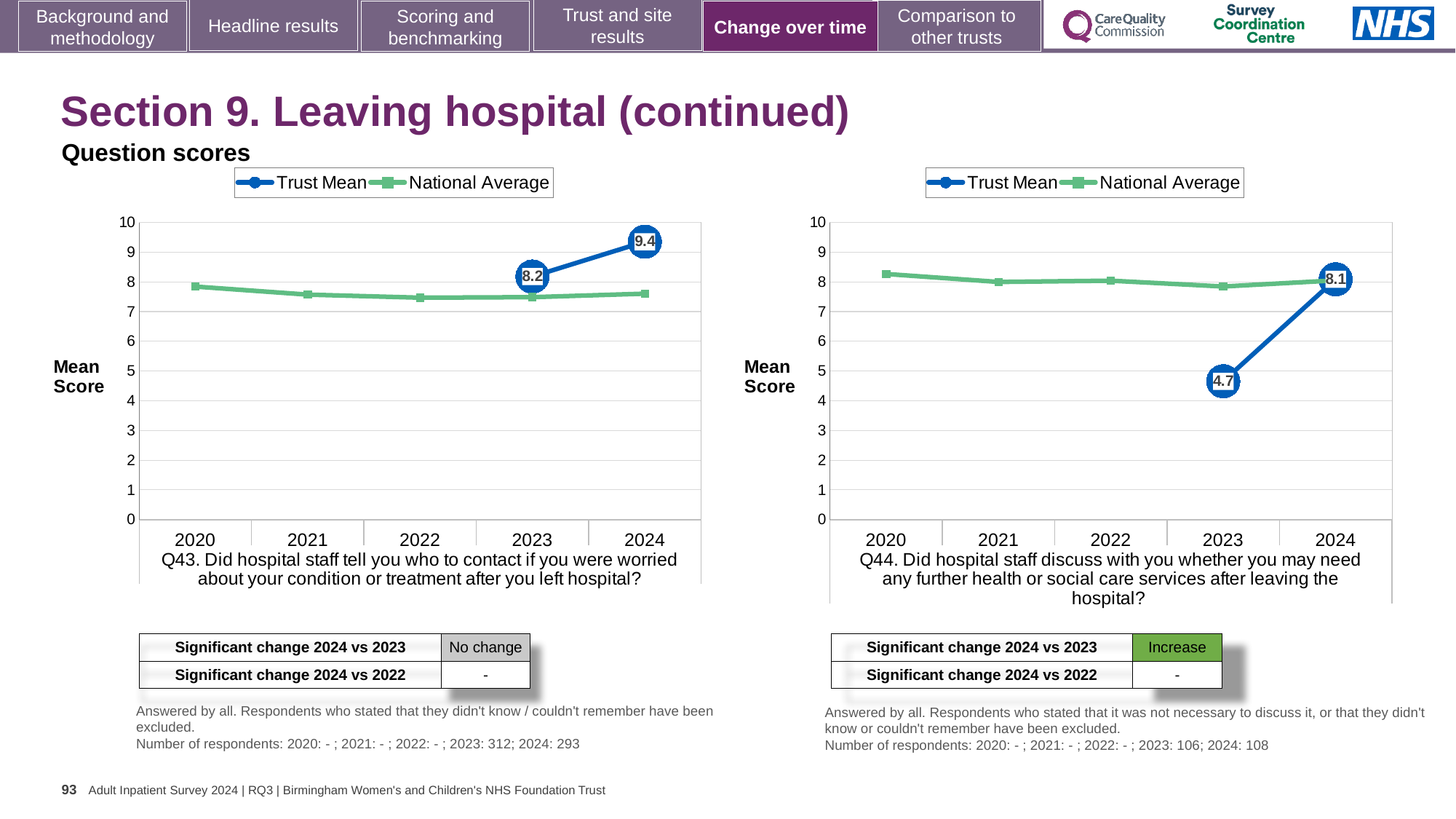
In the Q44 chart on the right, is the National Average value for 2020 greater or less than 8? greater In the Q43 chart on the left, what is the Trust Mean score for 2024? 9.4 What type of chart is used for the Q43 chart on the left? Line chart In the Q44 chart on the right, what is the Trust Mean score for 2023? 4.7 In the Q44 chart on the right, what is the difference between the Trust Mean in 2024 and in 2023? 3.4 In the Q43 chart on the left, by how much did the Trust Mean increase from 2023 to 2024? 1.2 How many series does the legend of the Q44 chart on the right list? 2 In the Q44 chart on the right, which is larger in 2023: the Trust Mean or the National Average? National Average In the Q44 chart on the right, what is the Trust Mean score for 2024? 8.1 In the Q43 chart on the left, what is the Trust Mean score for 2023? 8.2 How many years are shown on the x axis of the Q43 chart on the left? 5 In the Q43 chart on the left, is the National Average value for 2022 greater or less than 8? less